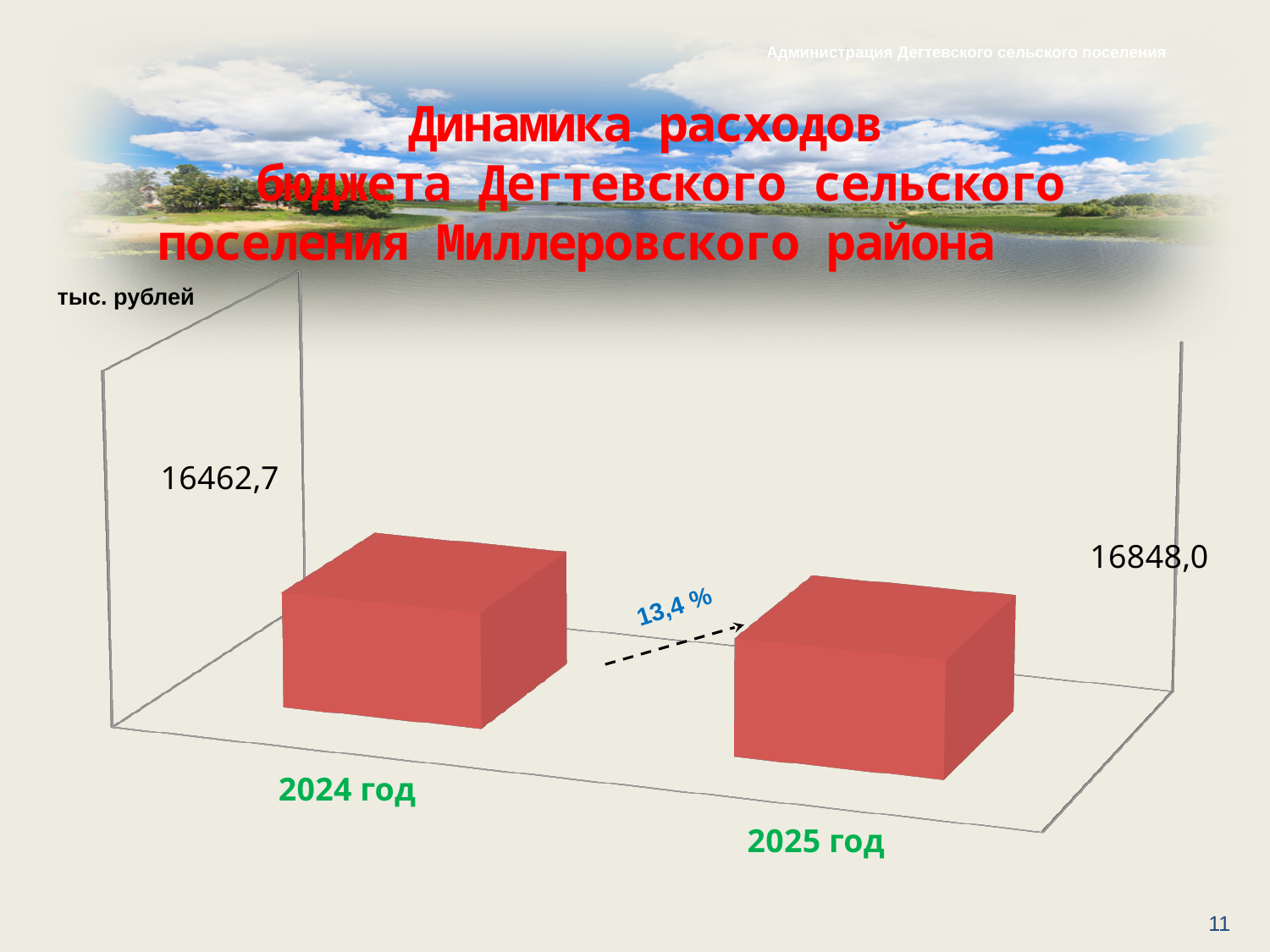
Which category has the highest value? 2025 год What is the difference between the values for 2025 год and 2024 год? 385,3 What is the value for 2025 год? 16848,0 What percentage change is written on the arrow between the two bars? 13,4 % Do the values rise or fall from 2024 год to 2025 год? Rise How many categories are shown in the chart? 2 What kind of chart is shown on the slide? Bar chart What unit of measurement is indicated for the chart values? тыс. рублей Which year has the higher value, 2024 год or 2025 год? 2025 год Which category has the lowest value? 2024 год What is the value for 2024 год? 16462,7